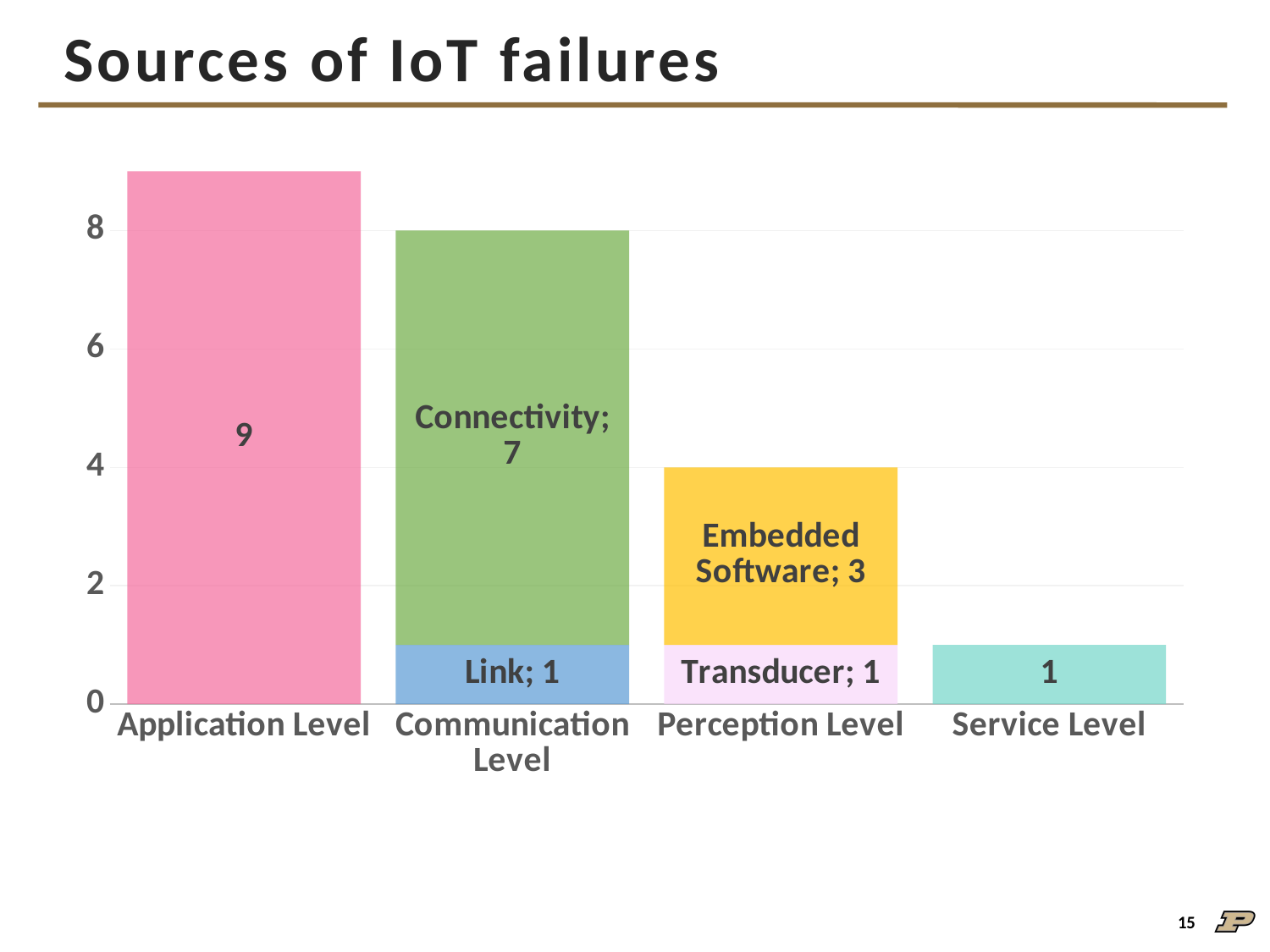
What kind of chart is shown on the slide? Stacked bar chart What is the total of the stacked Communication Level bar? 8 What is the value of the Embedded Software segment in the Perception Level bar? 3 What is the value for Service Level? 1 Which category has the lowest total value? Service Level What is the value for Application Level? 9 Which category has the highest total value? Application Level What is the total of the stacked Perception Level bar? 4 How many categories are shown on the x axis? 4 What is the value of the Connectivity segment in the Communication Level bar? 7 What is the difference between the Connectivity segment and the Link segment in the Communication Level bar? 6 What is the value of the Transducer segment in the Perception Level bar? 1